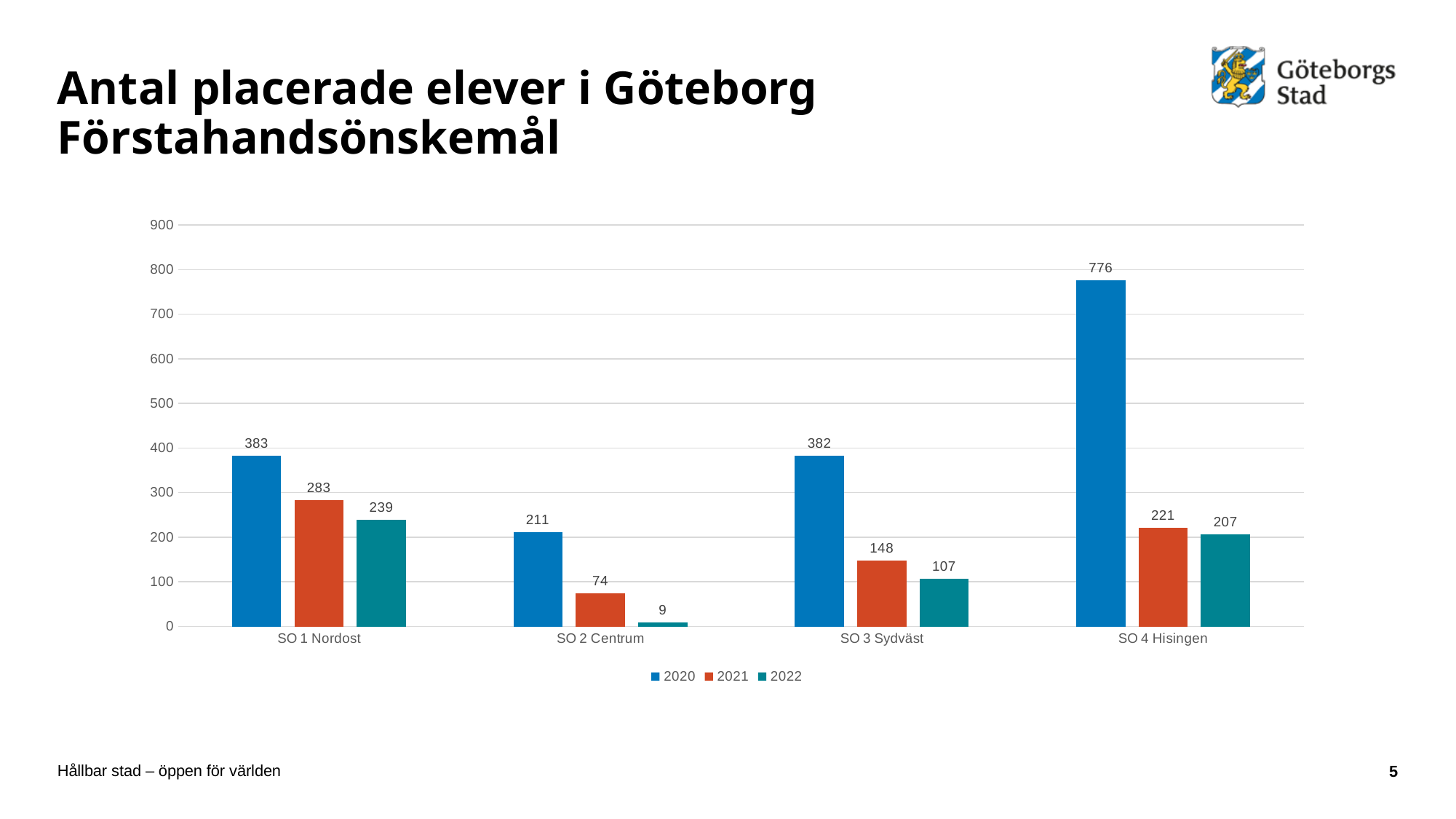
How many categories are shown on the x axis? 4 Which category has the highest value for 2020? SO 4 Hisingen Which category has the lowest value for 2022? SO 2 Centrum How many series does the legend list? 3 What is the value for 2021 in SO 3 Sydväst? 148 Which series is shown in blue in the legend? 2020 What is the difference between the 2020 and 2021 values in SO 1 Nordost? 100 What is the value for 2022 in SO 2 Centrum? 9 Which is larger: the 2021 value for SO 4 Hisingen or the 2021 value for SO 3 Sydväst? SO 4 Hisingen What kind of chart is shown on the slide? Bar chart Do the values for SO 3 Sydväst rise or fall from 2020 to 2022? Fall What is the value for 2020 in SO 4 Hisingen? 776